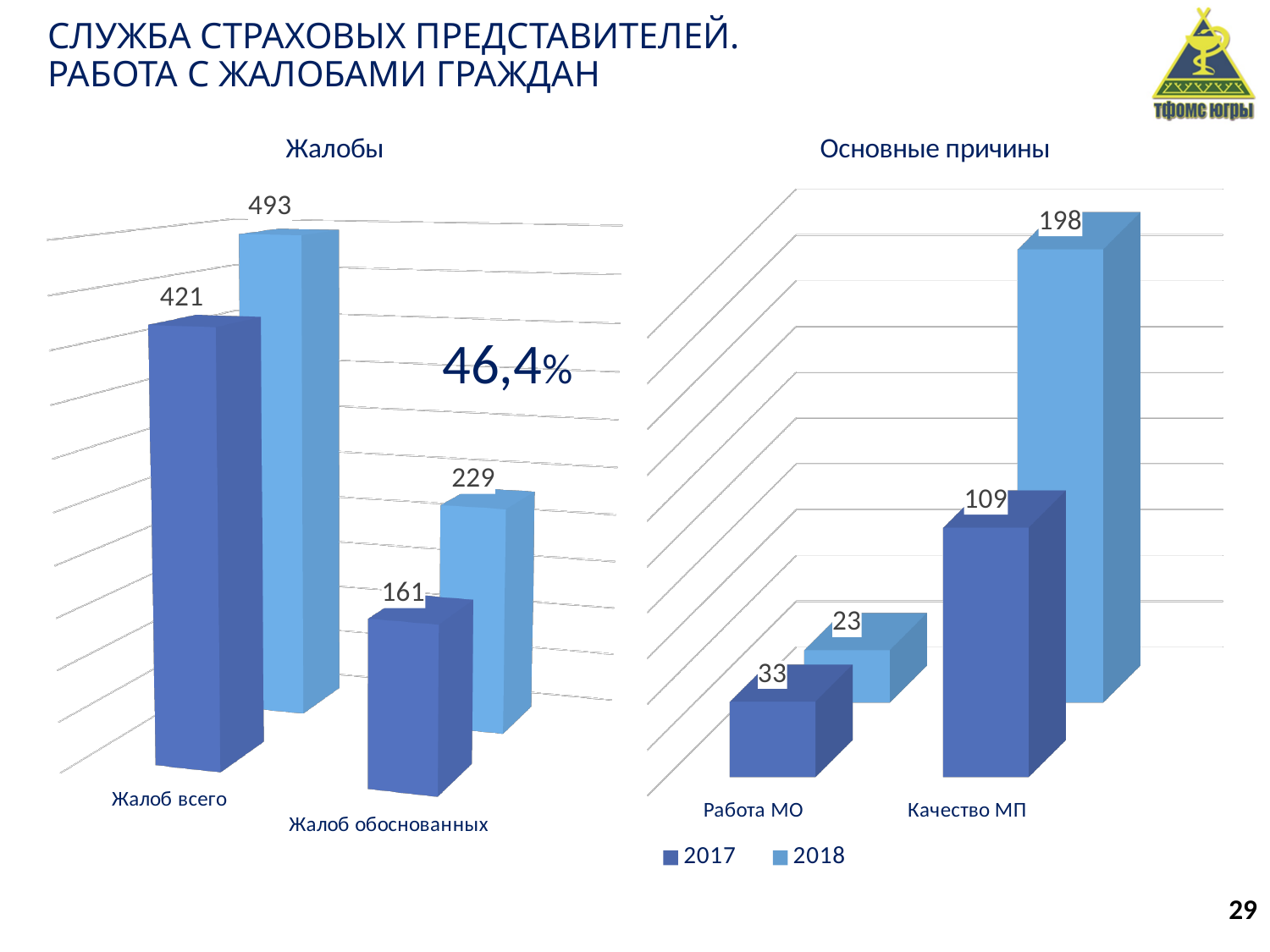
In the chart titled "Жалобы", what value is labeled on the dark blue bar for "Жалоб обоснованных"? 161 How many series does the legend of the chart titled "Основные причины" list? 2 In the chart titled "Основные причины", which year has the larger value for "Работа МО", 2017 or 2018? 2017 In the chart titled "Основные причины", what is the difference between the 2018 and 2017 values for "Качество МП"? 89 In the chart titled "Основные причины", what is the 2018 value for "Качество МП"? 198 What kind of chart is the chart titled "Жалобы"? bar chart How many categories are shown on the x axis of the chart titled "Основные причины"? 2 What percentage figure is printed inside the chart titled "Жалобы"? 46,4% In the chart titled "Жалобы", what is the difference between the two labeled values for "Жалоб всего" (493 and 421)? 72 In the chart titled "Жалобы", what value is labeled on the light blue bar for "Жалоб всего"? 493 In the chart titled "Основные причины", what is the 2017 value for "Работа МО"? 33 In the chart titled "Жалобы", which bar has the highest labeled value? The light blue bar for Жалоб всего (493)